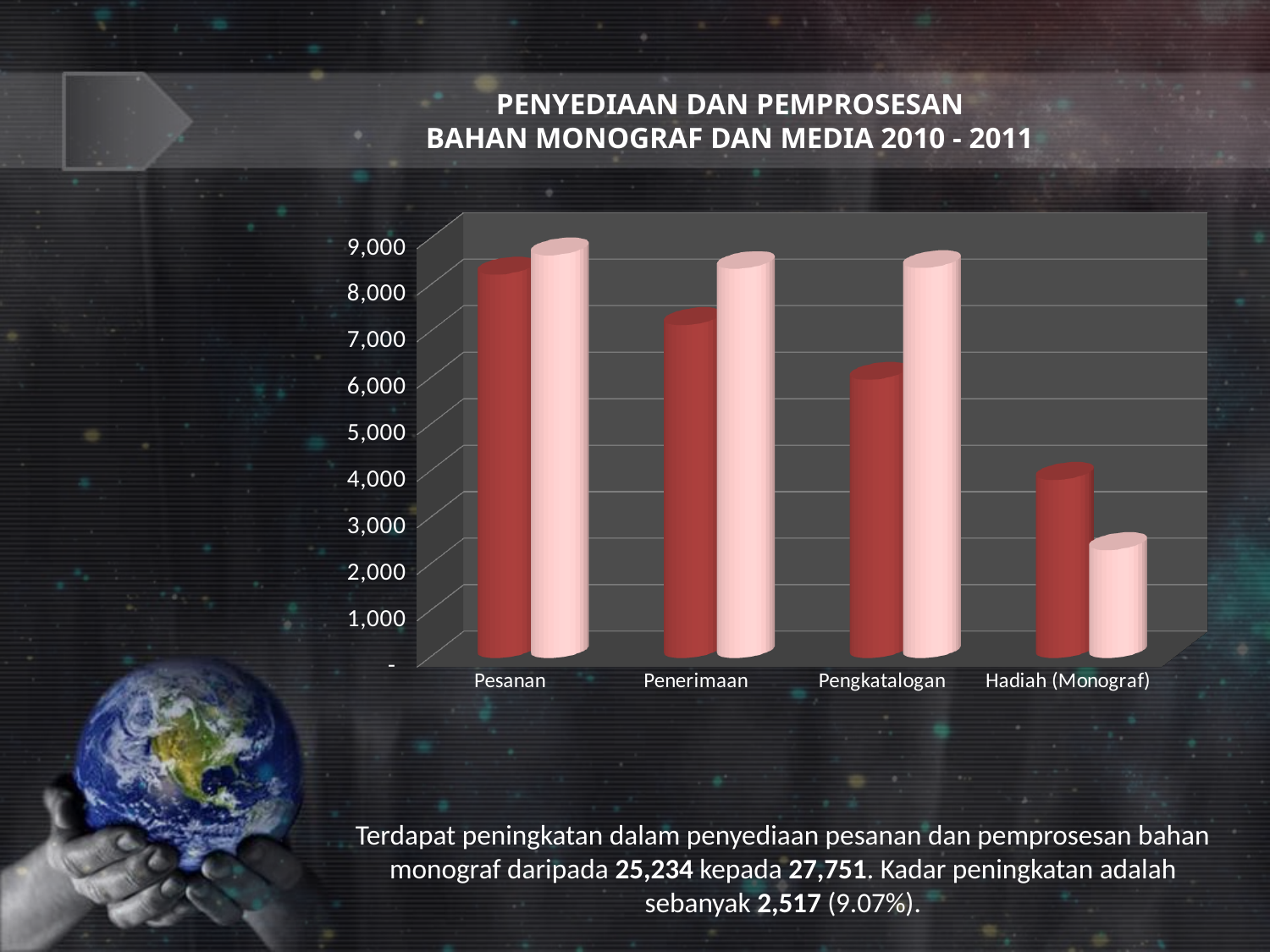
Is the dark red bar for Pesanan greater or less than 7,000? greater Which category has the highest dark red bar? Pesanan Which category has the lowest light pink bar? Hadiah (Monograf) Is the dark red bar for Pengkatalogan greater or less than 5,000? greater Do the dark red bars rise or fall from Pesanan to Hadiah (Monograf)? fall What is the title of the chart? PENYEDIAAN DAN PEMPROSESAN BAHAN MONOGRAF DAN MEDIA 2010 - 2011 What kind of chart is shown on the slide? bar chart Which category has the lowest dark red bar? Hadiah (Monograf) Is the dark red bar for Hadiah (Monograf) greater or less than 5,000? less How many categories are shown on the x axis of the chart? 4 For Hadiah (Monograf), which bar is taller, the dark red one or the light pink one? dark red